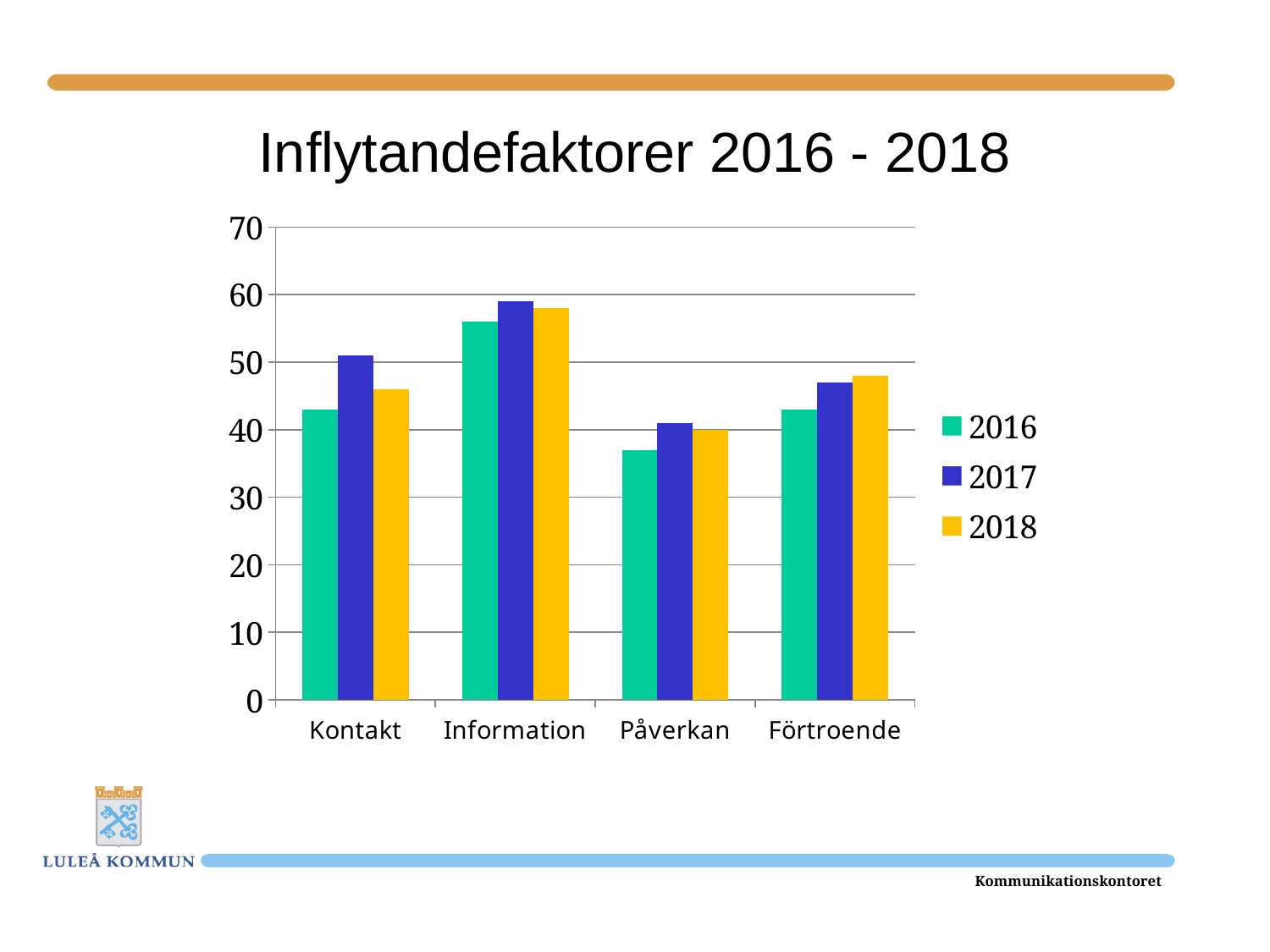
Is the value for Påverkan in 2016 greater or less than 40? less What kind of chart is shown on the slide? bar chart How many categories are shown on the x axis? 4 Which category has the highest value for 2017? Information Is the value for Kontakt in 2016 greater or less than 40? greater Which category has the lowest value for 2016? Påverkan Which is larger in 2018: Information or Påverkan? Information Is the value for Information in 2016 greater or less than 50? greater How many series does the legend list? 3 What is the title of the chart? Inflytandefaktorer 2016 - 2018 Which is larger for Kontakt: the 2016 value or the 2017 value? 2017